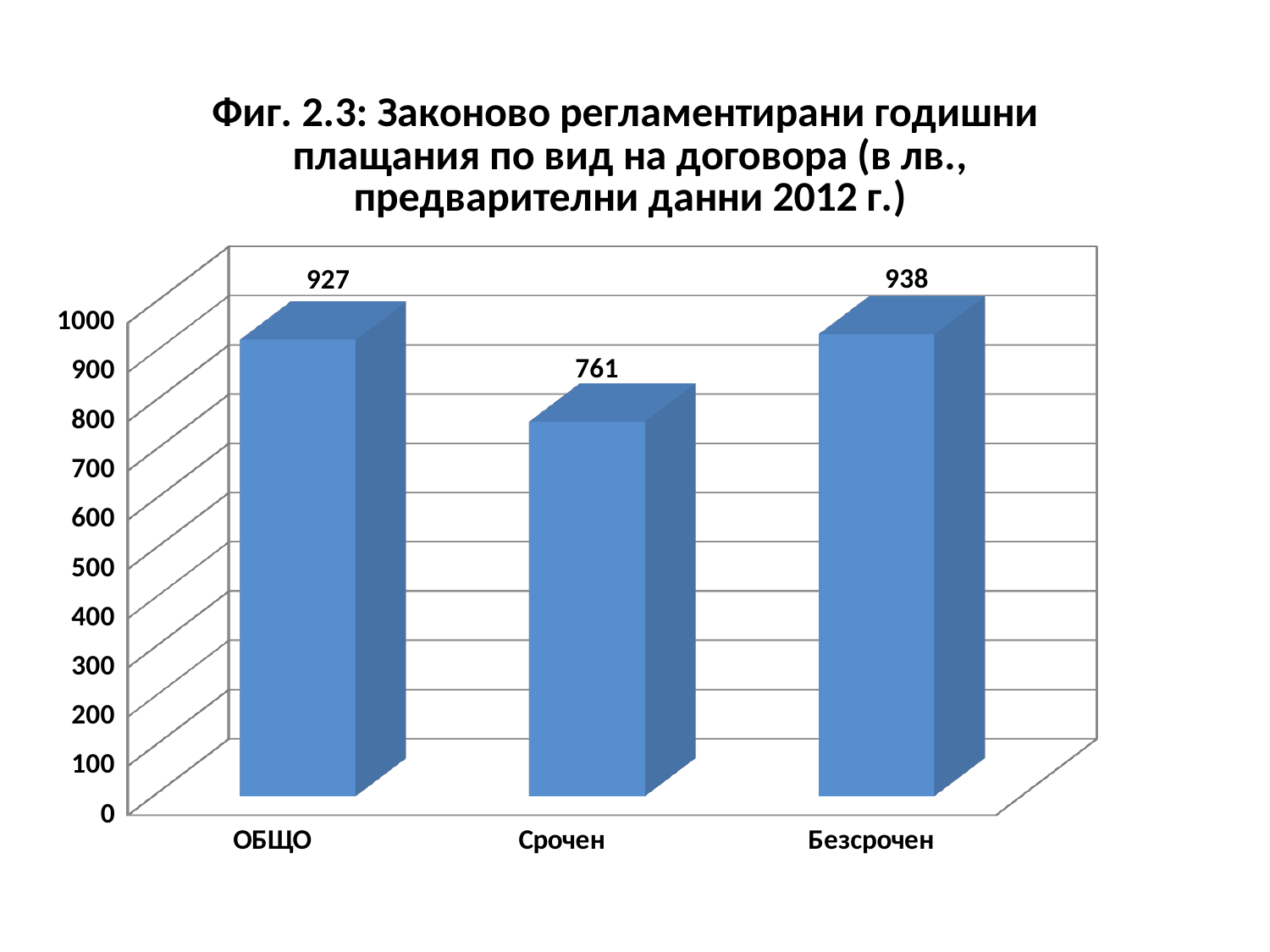
Which category has the highest value? Безсрочен What is the value for Срочен? 761 What is the value for Безсрочен? 938 Which is larger, the value for ОБЩО or the value for Срочен? ОБЩО What is the title of the chart? Фиг. 2.3: Законово регламентирани годишни плащания по вид на договора (в лв., предварителни данни 2012 г.) Which category has the lowest value? Срочен What kind of chart is shown on the slide? bar chart What is the difference between the values for Безсрочен and Срочен? 177 What is the value for ОБЩО? 927 How many categories are shown on the x axis? 3 Is the value for Срочен greater or less than 800? less What is the difference between the values for ОБЩО and Срочен? 166